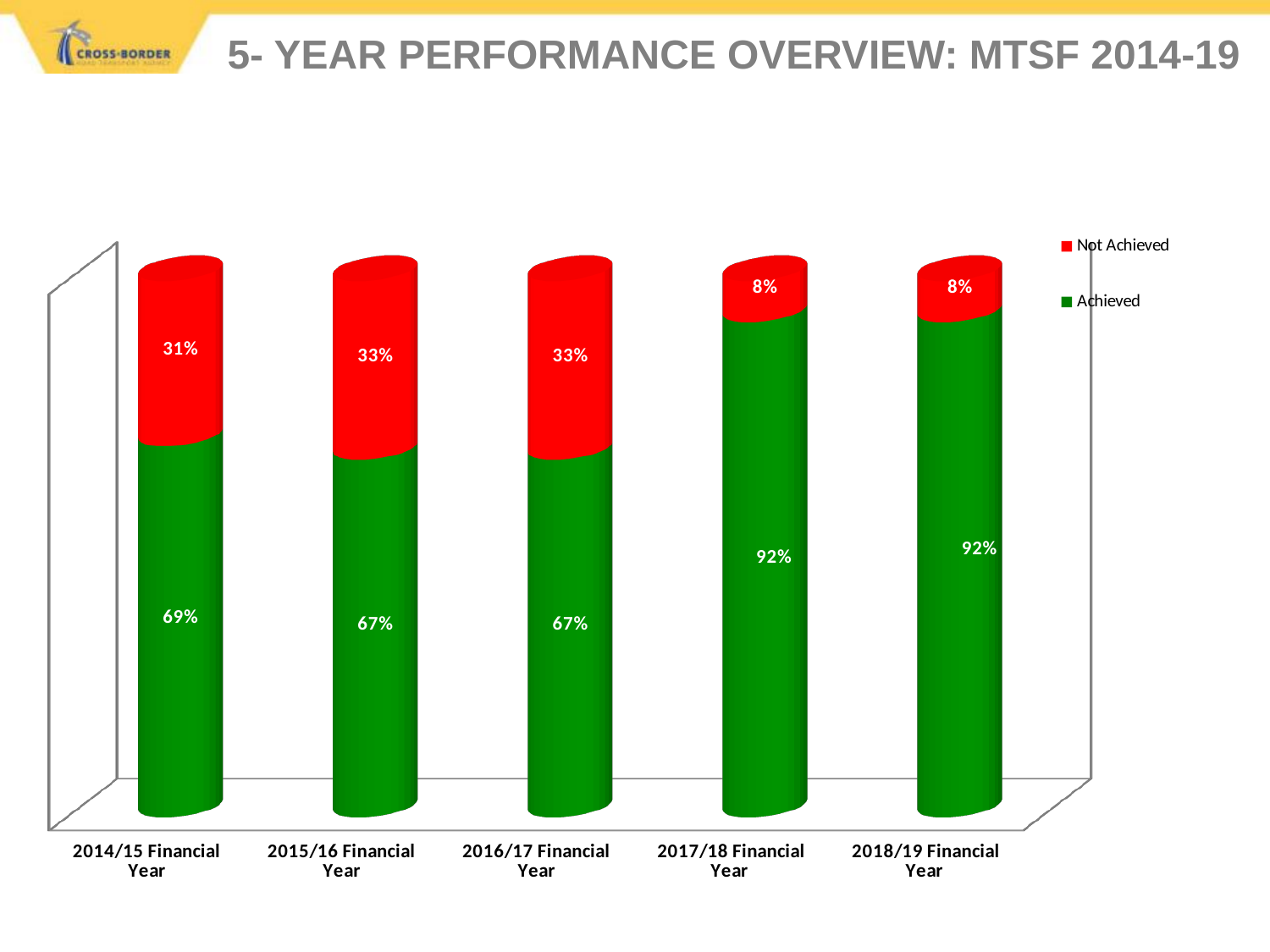
How many series does the legend list? 2 What percentage was Not Achieved in the 2016/17 Financial Year? 33% What is the difference between the Achieved percentage in 2017/18 and in 2014/15? 23% Which financial year has the lowest Achieved percentage? 2015/16 Financial Year and 2016/17 Financial Year (67%) What is the Achieved value for the 2018/19 Financial Year? 92% How many financial years are shown on the x axis? 5 What is the Not Achieved value for the 2017/18 Financial Year? 8% Which colour represents Not Achieved in the chart? Red Is the Achieved percentage larger in the 2015/16 Financial Year or the 2018/19 Financial Year? 2018/19 Financial Year What percentage was Achieved in the 2014/15 Financial Year? 69% What kind of chart is shown on the slide? Stacked bar chart Which financial year has the highest Not Achieved percentage? 2015/16 Financial Year and 2016/17 Financial Year (33%)